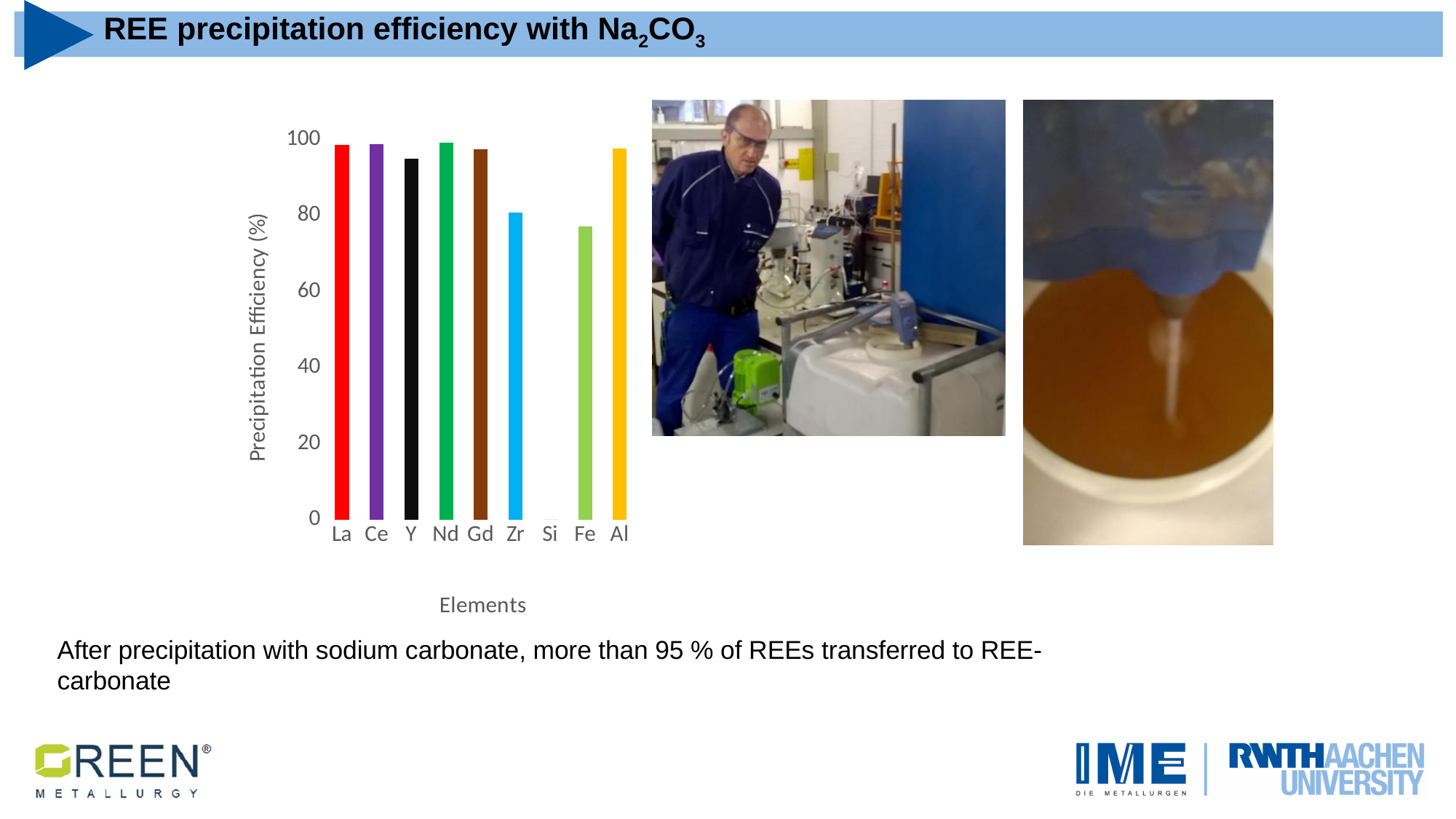
Is the precipitation efficiency for Si greater or less than 20? less Is the precipitation efficiency for Fe greater or less than 60? greater Is the precipitation efficiency for La greater or less than 80? greater Which has a higher precipitation efficiency, La or Fe? La What is the label of the x axis of the chart? Elements Which has a higher precipitation efficiency, Si or Zr? Zr What kind of chart is shown on the slide? bar chart Which element has the lowest precipitation efficiency in the chart? Si What is the label of the y axis of the chart? Precipitation Efficiency (%) How many elements are shown on the x axis of the chart? 9